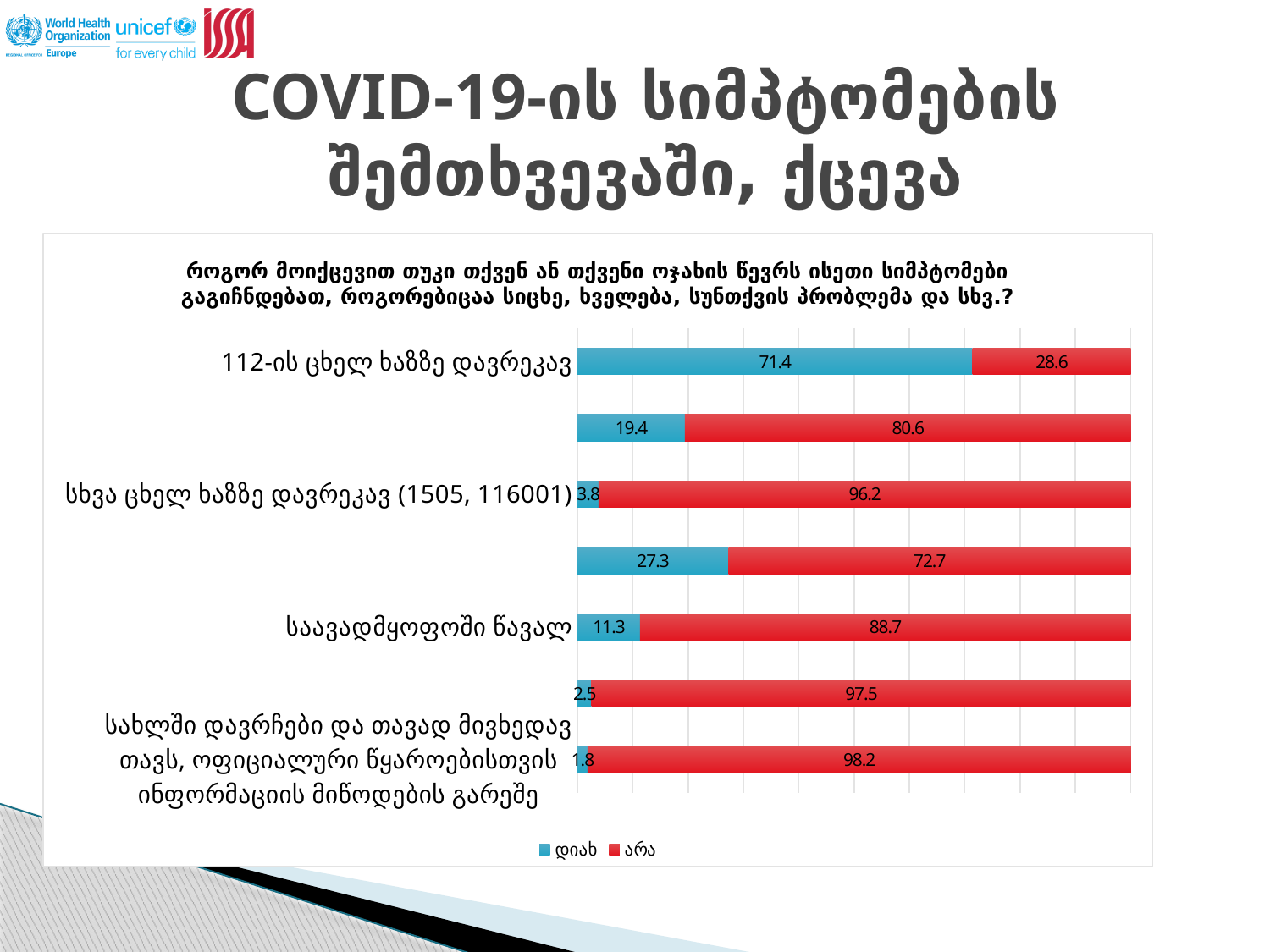
What is the არა value for "საავადმყოფოში წავალ"? 88.7 What is the difference between the დიახ and არა values for "112-ის ცხელ ხაზზე დავრეკავ"? 42.8 What is the დიახ value for "სხვა ცხელ ხაზზე დავრეკავ (1505, 116001)"? 3.8 Which has a larger დიახ value: "112-ის ცხელ ხაზზე დავრეკავ" or "საავადმყოფოში წავალ"? 112-ის ცხელ ხაზზე დავრეკავ Which category has the lowest დიახ value? სახლში დავრჩები და თავად მივხედავ თავს, ოფიციალური წყაროებისთვის ინფორმაციის მიწოდების გარეშე How many bars are plotted in the chart? 7 Which category has the highest დიახ value? 112-ის ცხელ ხაზზე დავრეკავ How many series does the legend list? 2 What is the დიახ value for "სახლში დავრჩები და თავად მივხედავ თავს, ოფიციალური წყაროებისთვის ინფორმაციის მიწოდების გარეშე"? 1.8 What is the value of the დიახ series for the category "112-ის ცხელ ხაზზე დავრეკავ"? 71.4 What kind of chart is shown on the slide? Stacked bar chart What is the value of the არა series for the category "112-ის ცხელ ხაზზე დავრეკავ"? 28.6